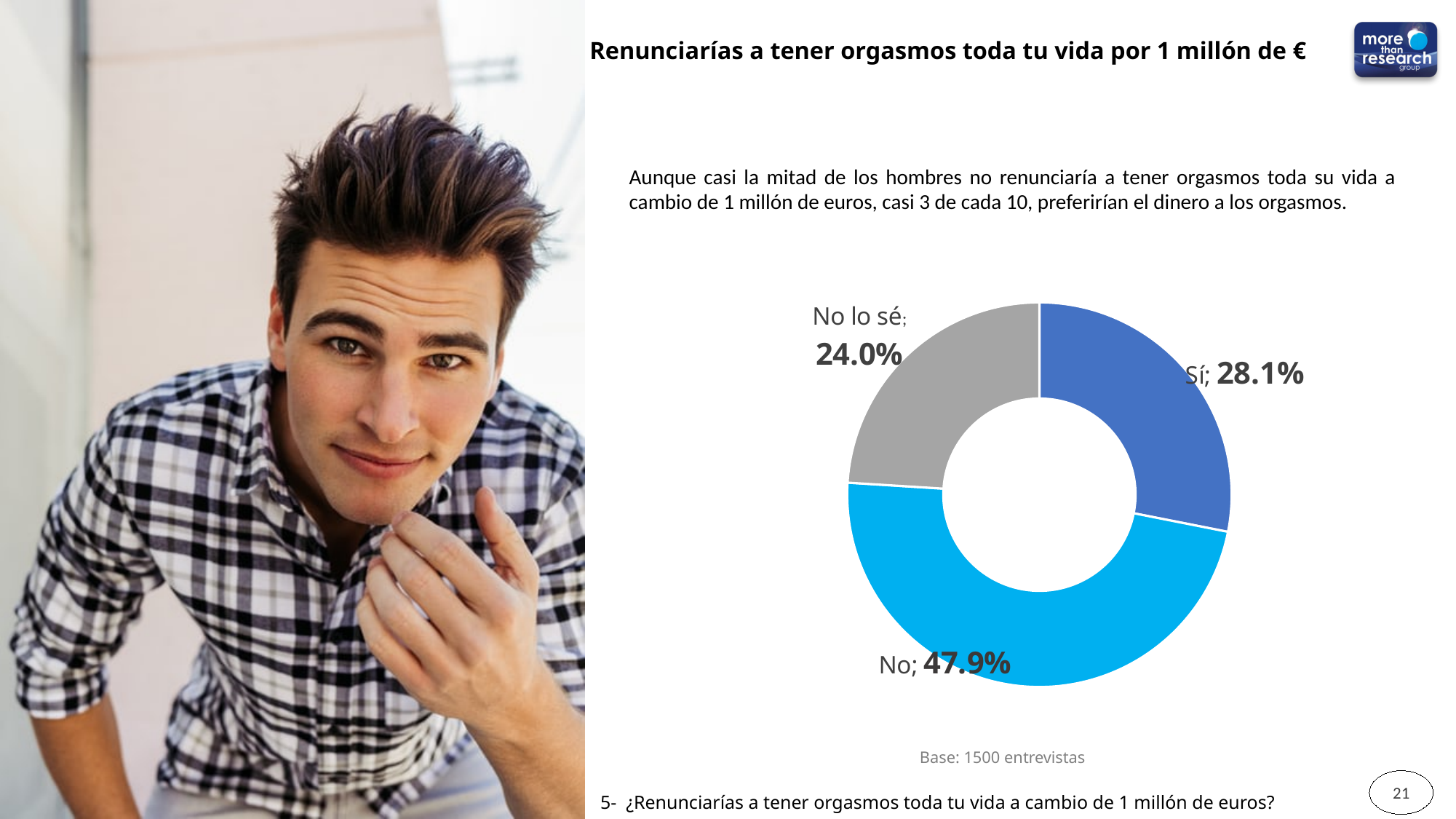
Which response has the largest share of the chart? No What percentage of respondents answered "No"? 47.9% What is the difference in percentage points between the "No" and "Sí" shares? 19.8 How many categories are shown in the chart? 3 What kind of chart is shown on the slide? Doughnut (pie) chart Which response has the smallest share of the chart? No lo sé What percentage of respondents answered "Sí"? 28.1% What is the base (number of interviews) stated below the chart? 1500 entrevistas What colour is the "No" segment of the chart? Light blue Which is larger, the share for "Sí" or the share for "No lo sé"? Sí What is the difference in percentage points between the "Sí" and "No lo sé" shares? 4.1 What percentage of respondents answered "No lo sé"? 24.0%